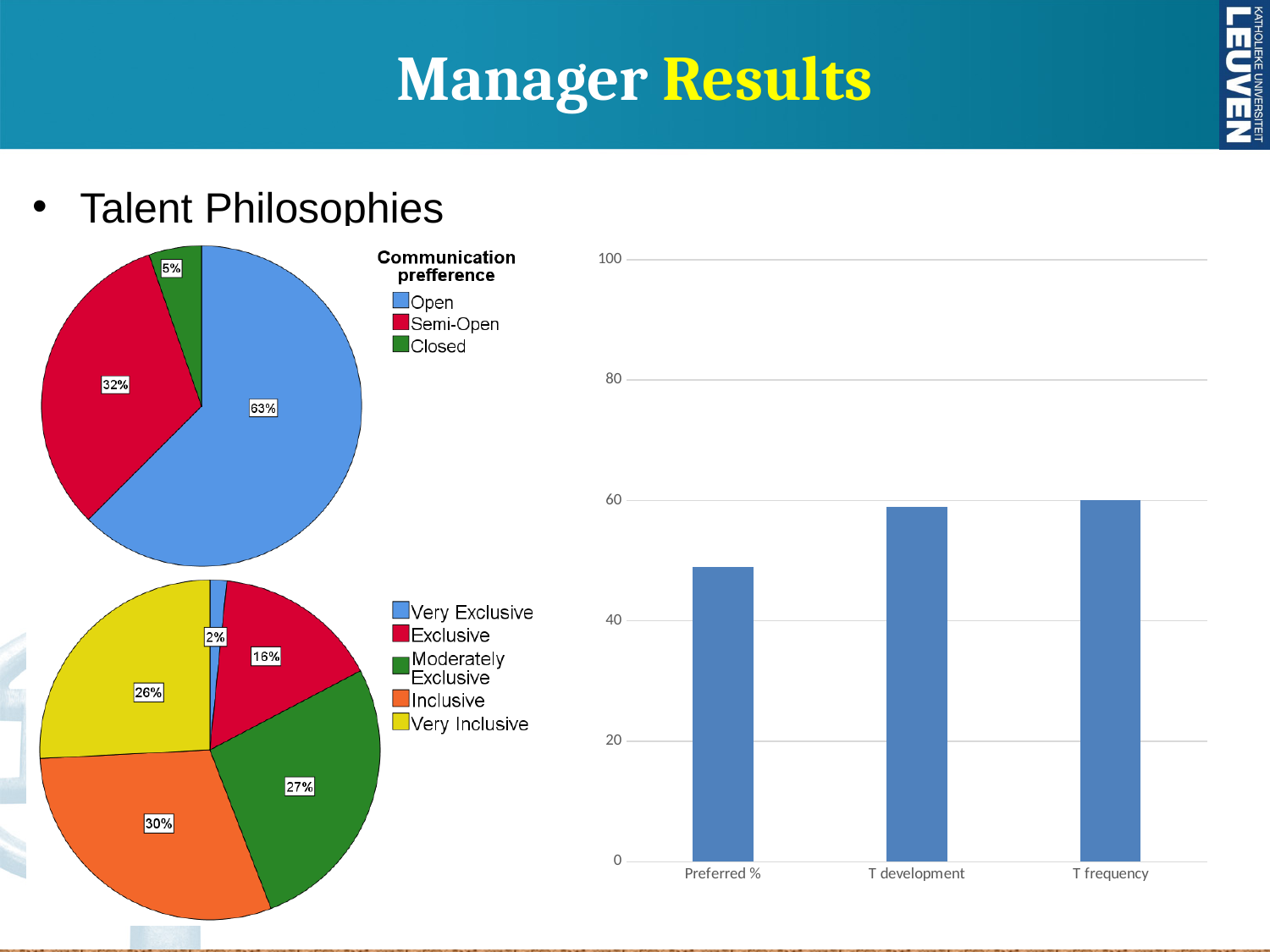
In the bottom-left pie chart, what percentage is Inclusive? 30% In the bottom-left pie chart, how many categories does the legend list? 5 What kind of chart is on the right side of the slide? bar chart In the bottom-left pie chart, which is larger, Exclusive or Very Inclusive? Very Inclusive In the Communication preference pie chart, how many categories does the legend list? 3 In the Communication preference pie chart, which category has the smallest share? Closed In the bottom-left pie chart, what percentage is Very Exclusive? 2% In the Communication preference pie chart, what percentage is Semi-Open? 32% In the Communication preference pie chart, what is the difference between the Open and Semi-Open shares? 31% In the Communication preference pie chart, what percentage is Open? 63% In the bottom-left pie chart, which category has the largest share? Inclusive In the bar chart on the right, is the value for Preferred % greater or less than 60? less